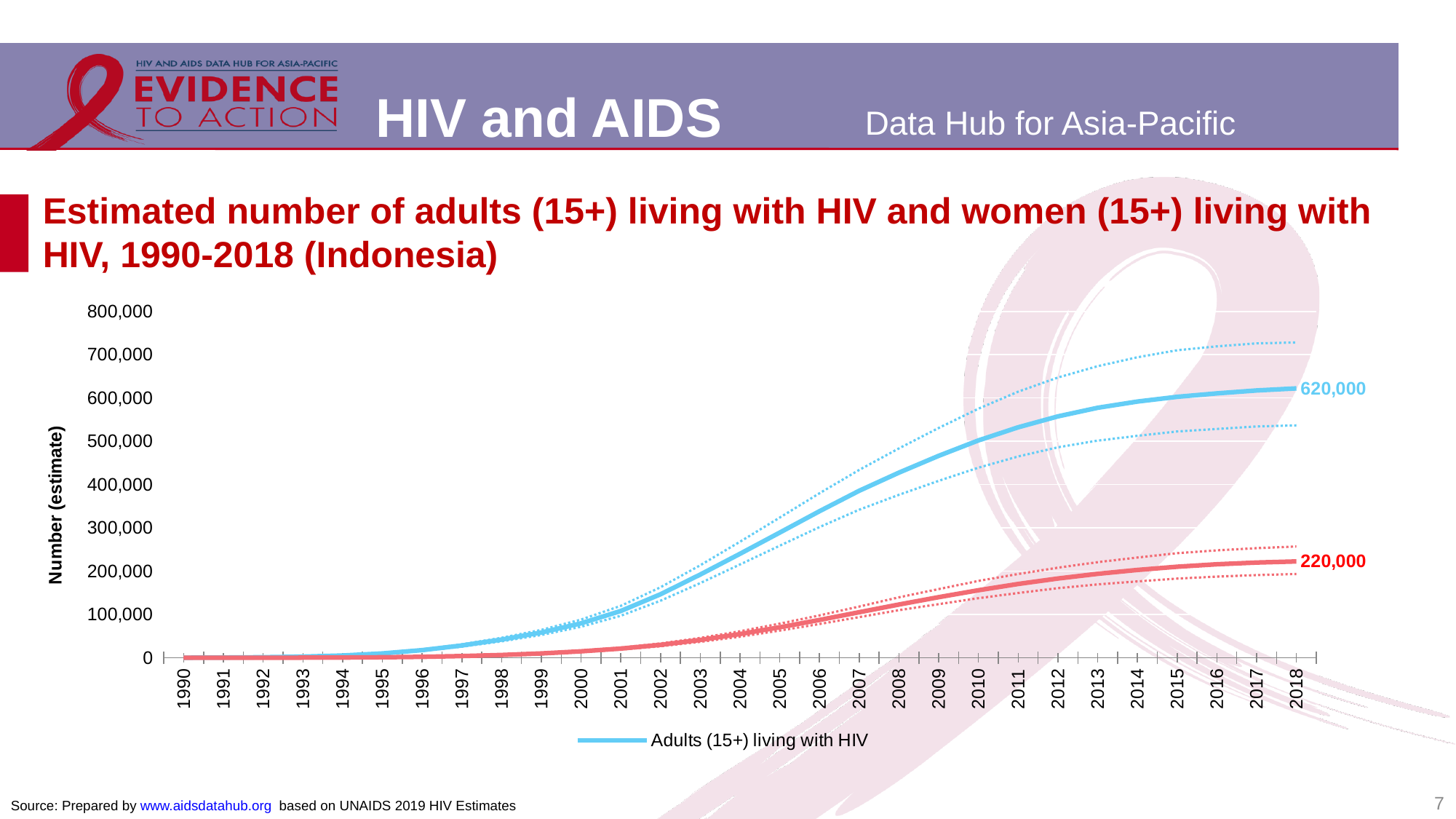
How many series does the chart legend list? 1 What is the difference between the 2018 values for adults (15+) living with HIV and women (15+) living with HIV? 400,000 What is the value shown at the end of the red line (women 15+ living with HIV) in 2018? 220,000 How many years are shown on the x axis of the chart? 29 In 2018, which is larger: the number of adults (15+) living with HIV or the number of women (15+) living with HIV? Adults (15+) living with HIV Is the value for Adults (15+) living with HIV in 1995 greater or less than 100,000? less Does the number of adults (15+) living with HIV rise or fall from 1990 to 2018? Rise Is the value of the red line (women 15+ living with HIV) in 2005 greater or less than 100,000? less What kind of chart is shown on the slide? Line chart What is the title of the y axis? Number (estimate) Is the value for Adults (15+) living with HIV in 2010 greater or less than 400,000? greater What is the value shown for Adults (15+) living with HIV in 2018? 620,000